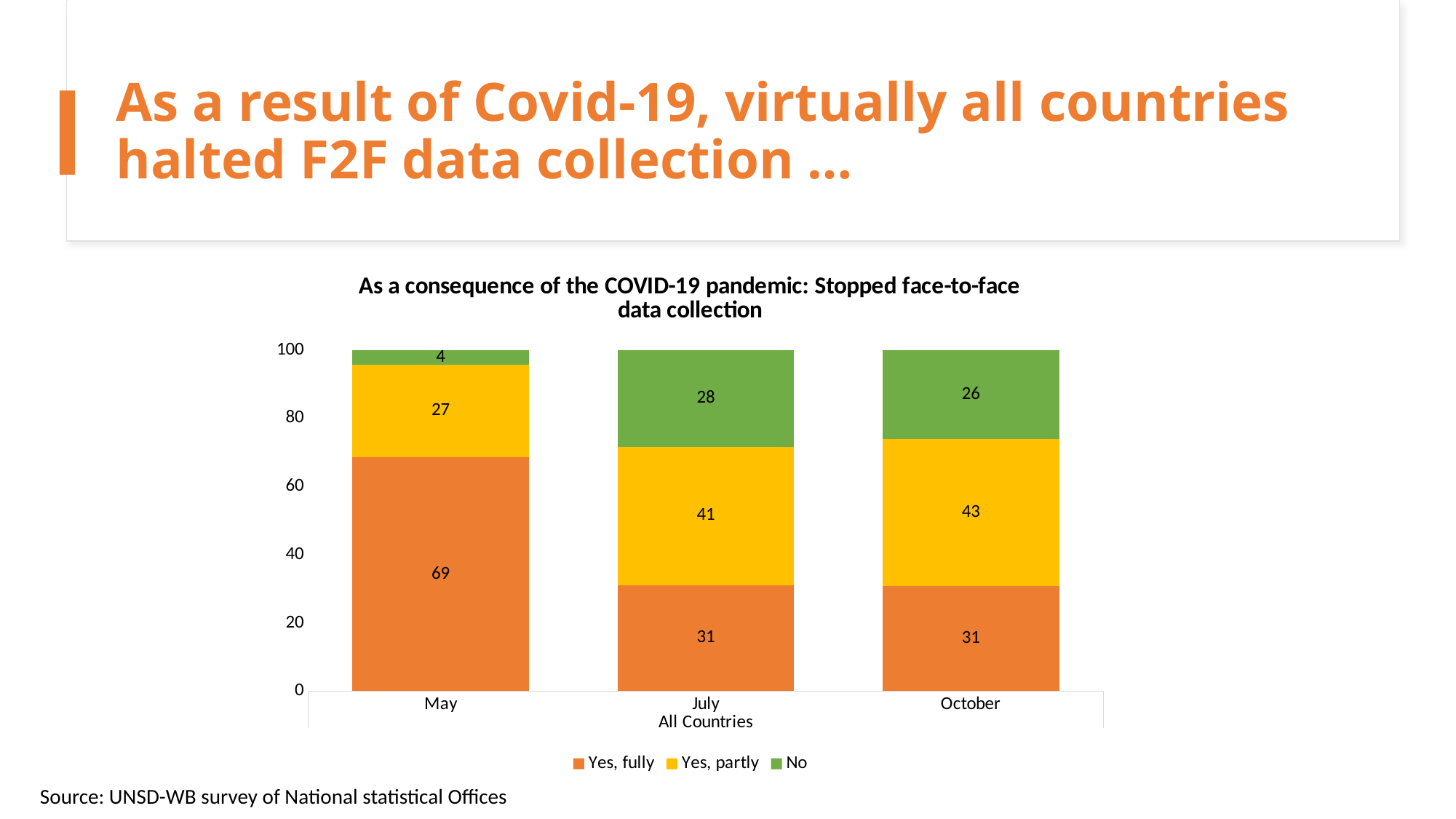
What is the value for "Yes, fully" in May? 69 What is the total of the stacked bar for July? 100 In which month is the "Yes, fully" value highest? May What is the value for "Yes, partly" in October? 43 How many series does the legend list? 3 What kind of chart is shown? Stacked bar chart How many months are shown on the x axis? 3 Does the "Yes, fully" value rise or fall from May to July? Fall What is the difference between the "Yes, partly" values for October and May? 16 In which month is the "No" value lowest? May What is the value for "No" in July? 28 Which is larger: the "No" value in July or in October? July